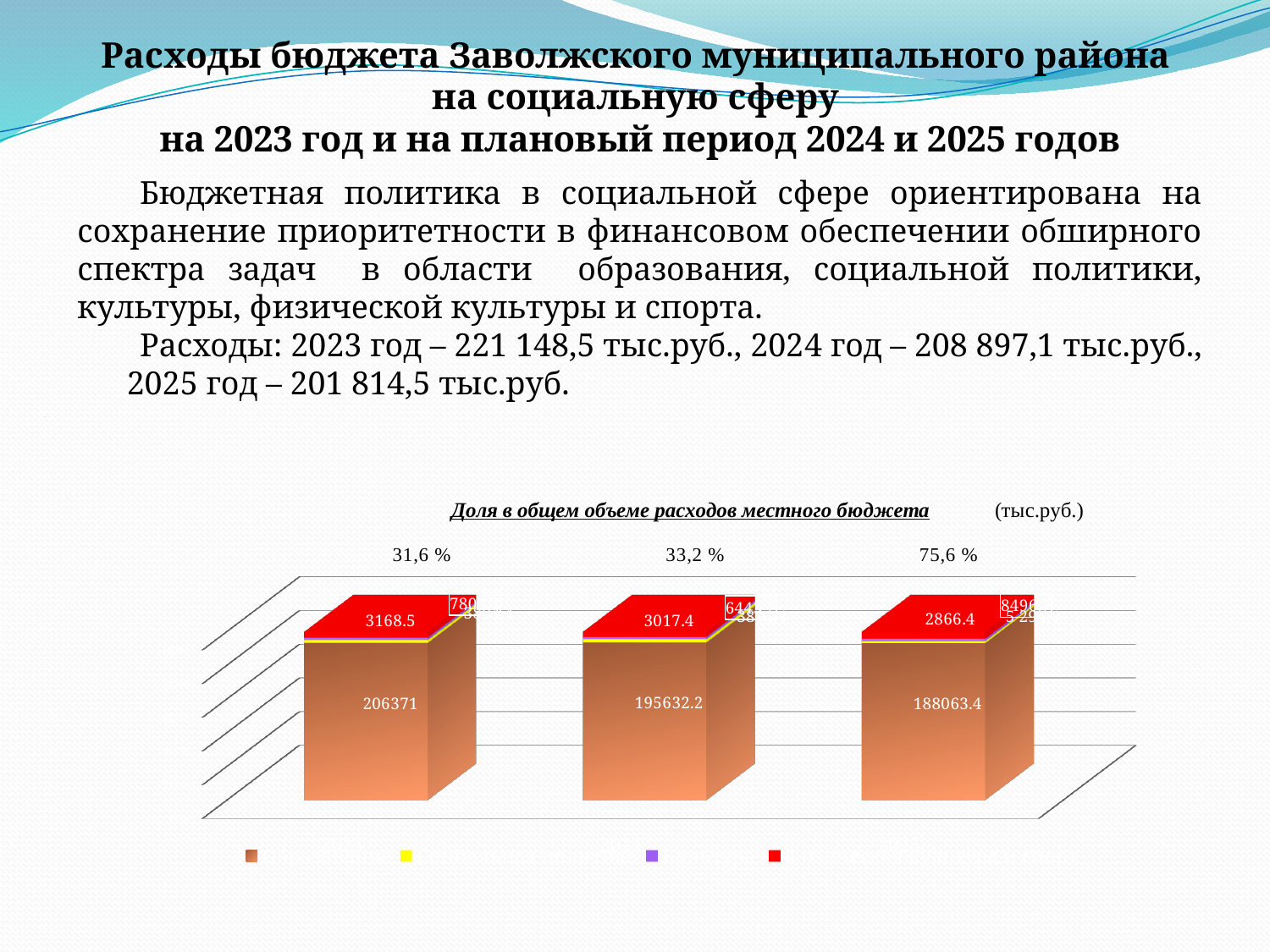
What is the value printed on the large bottom segment of the left bar? 206371 Which bar has the largest bottom segment value: left, middle or right? left What is the value printed on the large bottom segment of the right bar? 188063.4 What percentage is printed above the right bar? 75,6 % What is the value printed on the red top segment of the left bar? 3168.5 What is the value printed on the red top segment of the right bar? 2866.4 What is the difference between the red segment values of the left bar (3168.5) and the right bar (2866.4)? 302.1 What is the value printed on the large bottom segment of the middle bar? 195632.2 Which is larger: the bottom segment of the middle bar or the bottom segment of the right bar? middle bar How many bars are shown in the chart? 3 Which bar has the smallest red top segment value: left, middle or right? right Do the bottom segment values rise or fall from the left bar to the right bar? fall